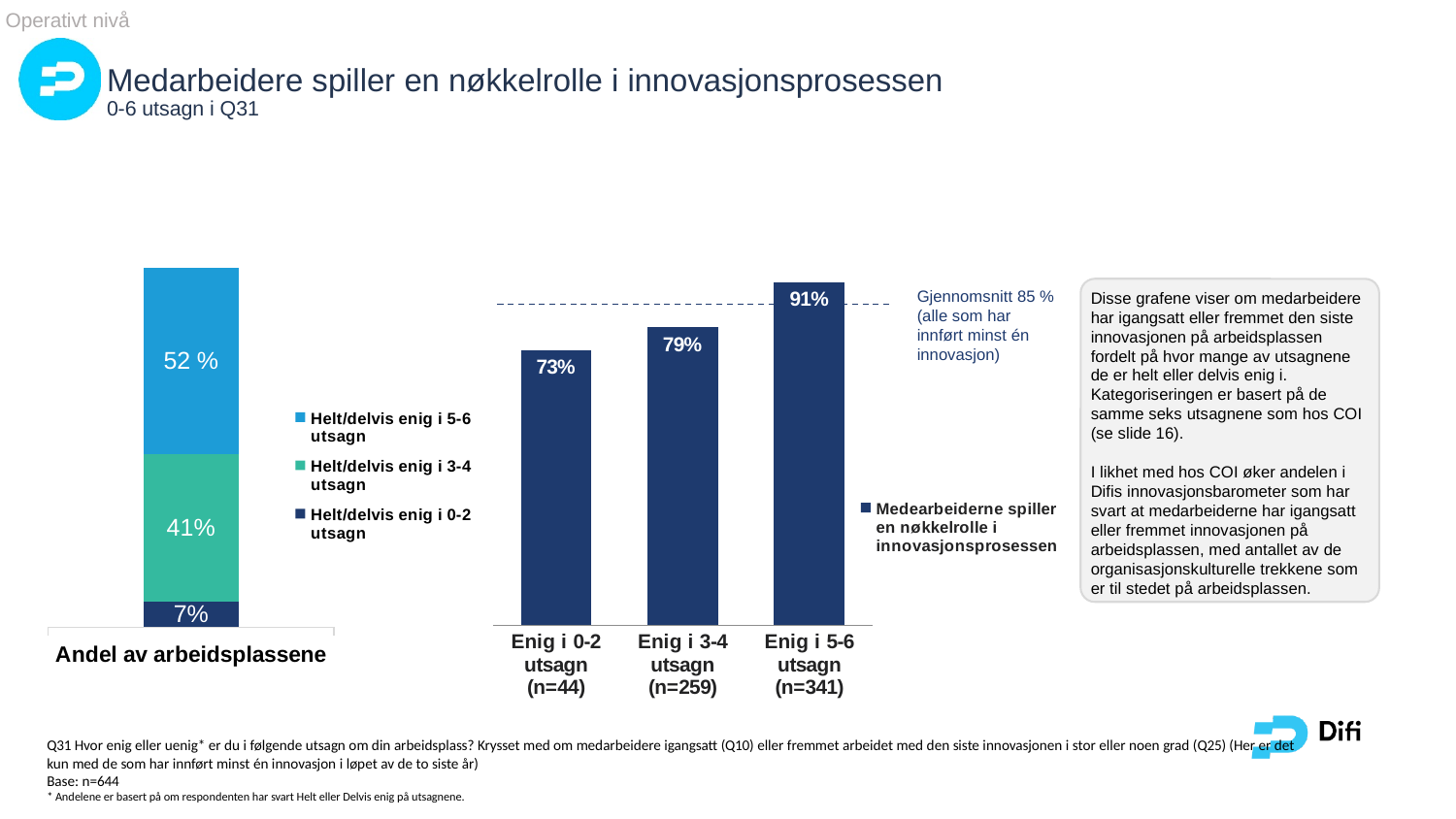
In the right chart, what average value does the dashed line represent (Gjennomsnitt)? 85 % In the left chart (Andel av arbeidsplassene), what share of workplaces agree with 3-4 statements? 41% In the right chart, how many categories are shown on the x axis? 3 In the right chart, what is the value for 'Enig i 0-2 utsagn (n=44)'? 73% In the right chart, do the values rise or fall from 'Enig i 0-2 utsagn' to 'Enig i 5-6 utsagn'? rise In the left chart (Andel av arbeidsplassene), what share of workplaces agree with 0-2 statements? 7% In the left chart (Andel av arbeidsplassene), which segment is the largest? Helt/delvis enig i 5-6 utsagn In the right chart, what is the value for 'Enig i 5-6 utsagn (n=341)'? 91% In the right chart, what is the difference between 'Enig i 5-6 utsagn' and 'Enig i 3-4 utsagn'? 12% In the left chart (Andel av arbeidsplassene), what share of workplaces agree with 5-6 statements (Helt/delvis enig i 5-6 utsagn)? 52 % In the right chart, which category has the lowest value? Enig i 0-2 utsagn (n=44) In the left chart (Andel av arbeidsplassene), how many series does the legend list? 3